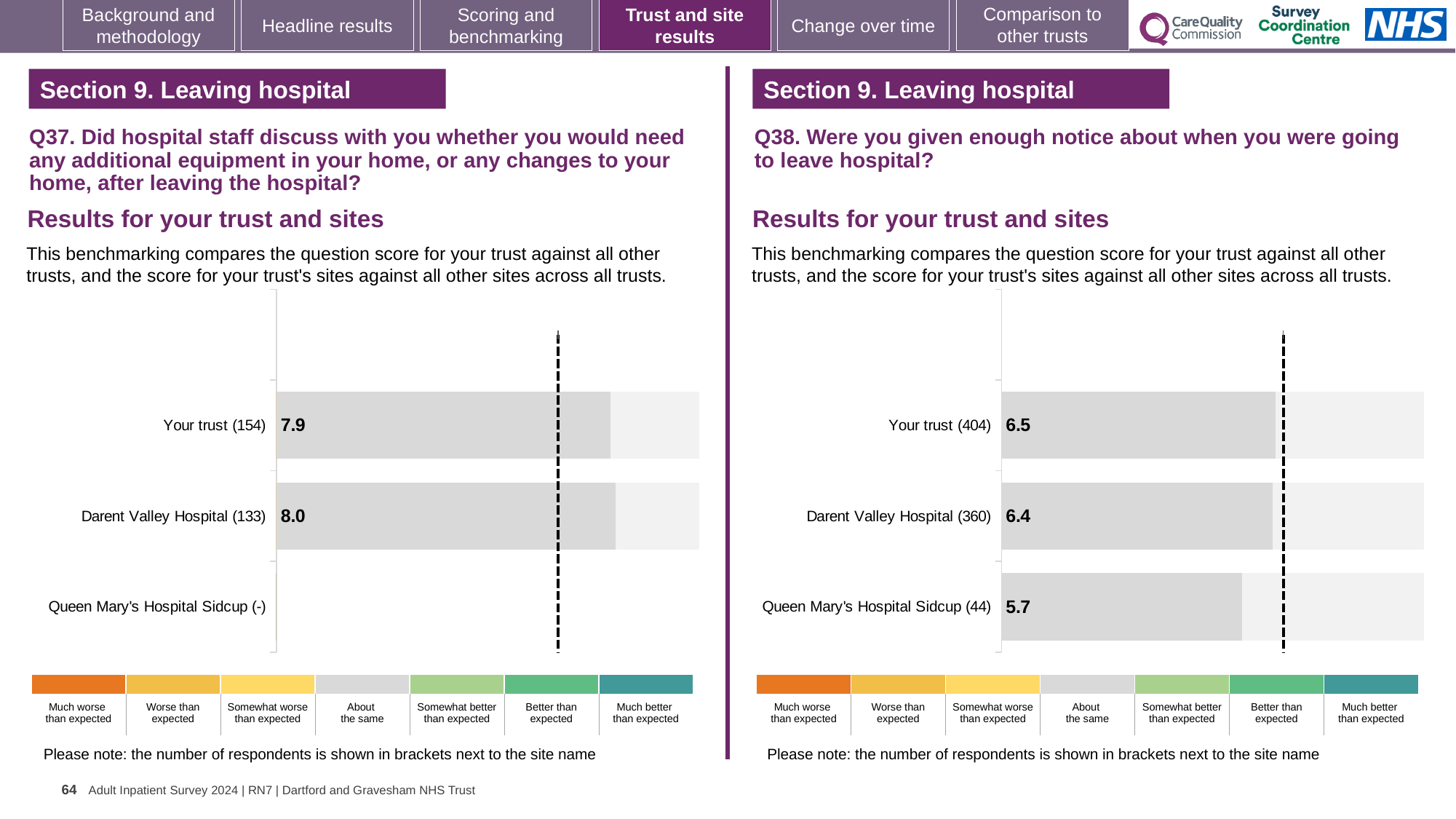
On the Q37 chart (left), how many respondents are shown in brackets for Darent Valley Hospital? 133 On the Q38 chart (right), how many respondents are shown in brackets for Your trust? 404 On the Q38 chart (right), what is the score for Queen Mary's Hospital Sidcup? 5.7 On the Q38 chart (right), what is the score for Your trust? 6.5 On the Q37 chart (left), what is the score for Darent Valley Hospital? 8.0 On the Q37 chart (left), which site has no score shown (marked with a dash)? Queen Mary's Hospital Sidcup On the Q38 chart (right), which site or trust has the lowest score? Queen Mary's Hospital Sidcup On the Q38 chart (right), what is the difference between the scores for Your trust and Queen Mary's Hospital Sidcup? 0.8 What type of chart is used on the Q37 chart (left)? Bar chart On the Q37 chart (left), what is the score for Your trust? 7.9 On the Q38 chart (right), which has the higher score: Darent Valley Hospital or Queen Mary's Hospital Sidcup? Darent Valley Hospital On the Q38 chart (right), how many categories (trust and sites) are listed? 3